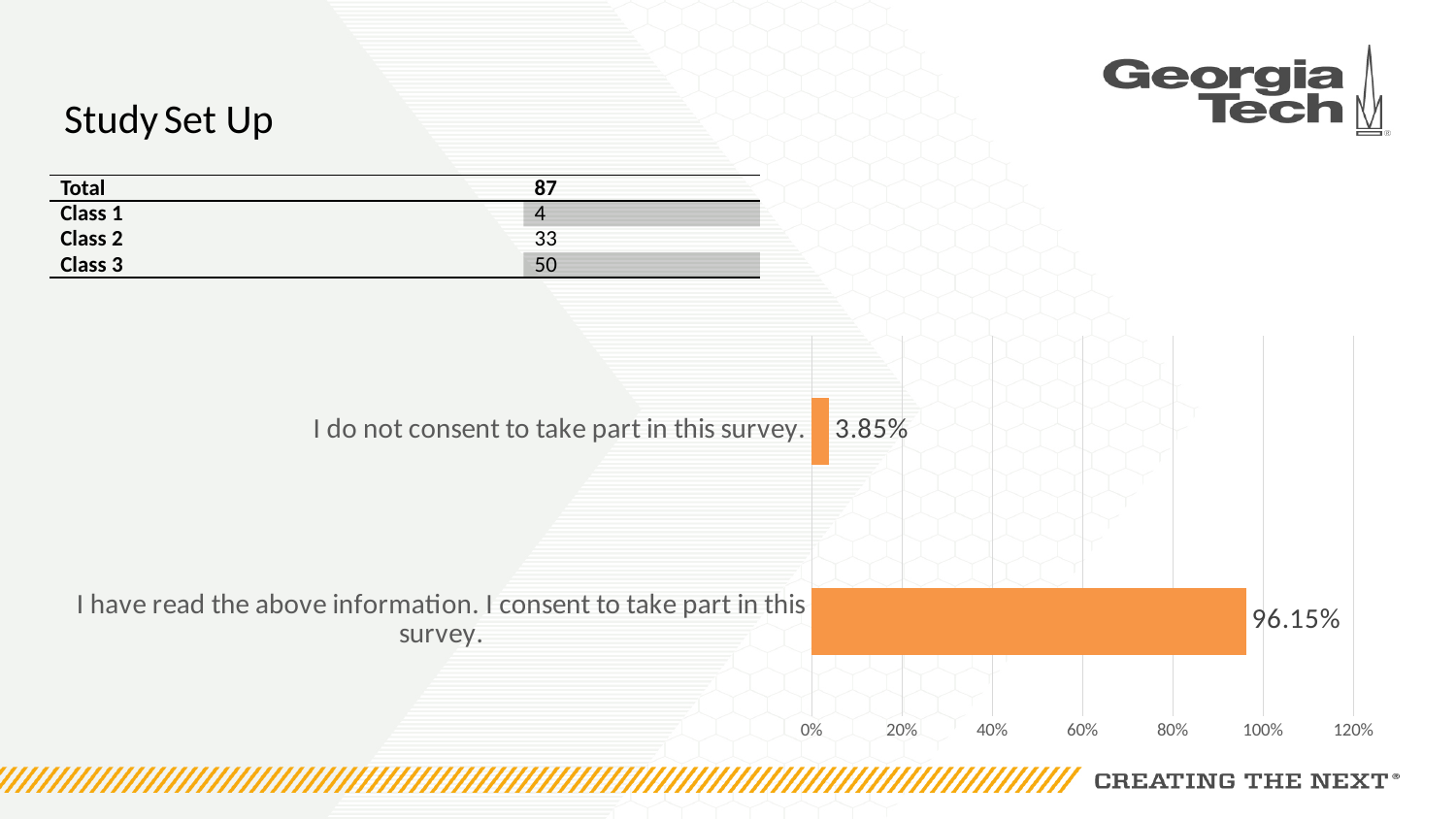
Is the value for "I do not consent to take part in this survey." greater or less than 20%? less Which category has the highest value? I have read the above information. I consent to take part in this survey. What is the difference between the value for "I have read the above information. I consent to take part in this survey." and the value for "I do not consent to take part in this survey."? 92.3% How many categories are plotted in the chart? 2 What colour are the bars in the chart? orange Which category has the lowest value? I do not consent to take part in this survey. Which is larger: the value for "I do not consent to take part in this survey." or the value for "I have read the above information. I consent to take part in this survey."? I have read the above information. I consent to take part in this survey. What is the value for "I have read the above information. I consent to take part in this survey."? 96.15% What is the value for "I do not consent to take part in this survey."? 3.85% Is the value for "I have read the above information. I consent to take part in this survey." greater or less than 80%? greater What is the highest tick label shown on the horizontal axis of the chart? 120% What kind of chart is shown on the slide? bar chart